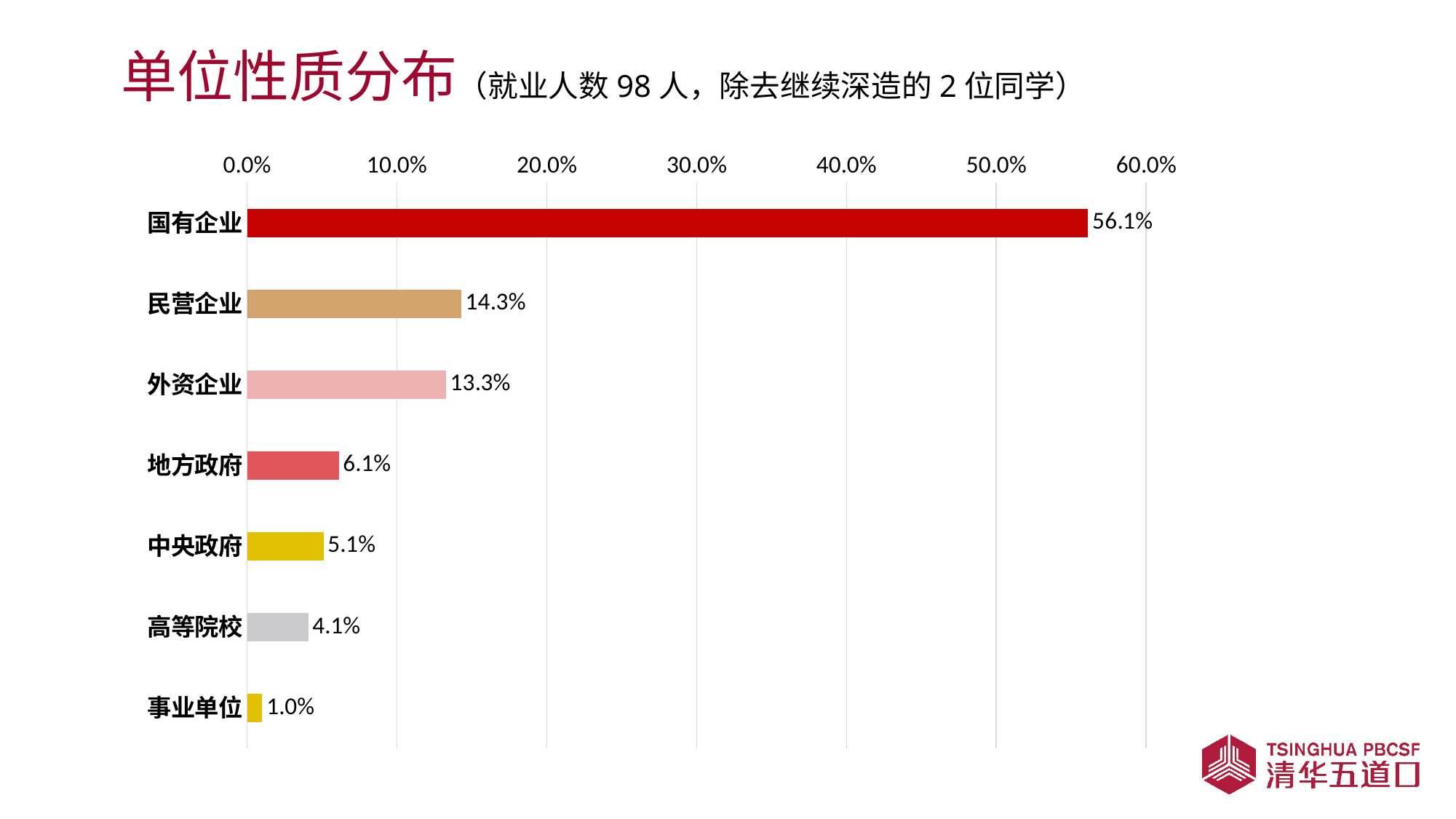
What kind of chart is shown on the slide? Bar chart What is the value for 外资企业? 13.3% What is the value for 高等院校? 4.1% What is the value for 国有企业? 56.1% How many categories are shown in the chart? 7 Which category has the highest value? 国有企业 Which is larger, the value for 民营企业 or the value for 外资企业? 民营企业 What is the value for 民营企业? 14.3% What is the title of the chart? 单位性质分布 What is the difference between the values for 国有企业 and 民营企业? 41.8% What is the difference between the values for 地方政府 and 中央政府? 1.0% Which category has the lowest value? 事业单位